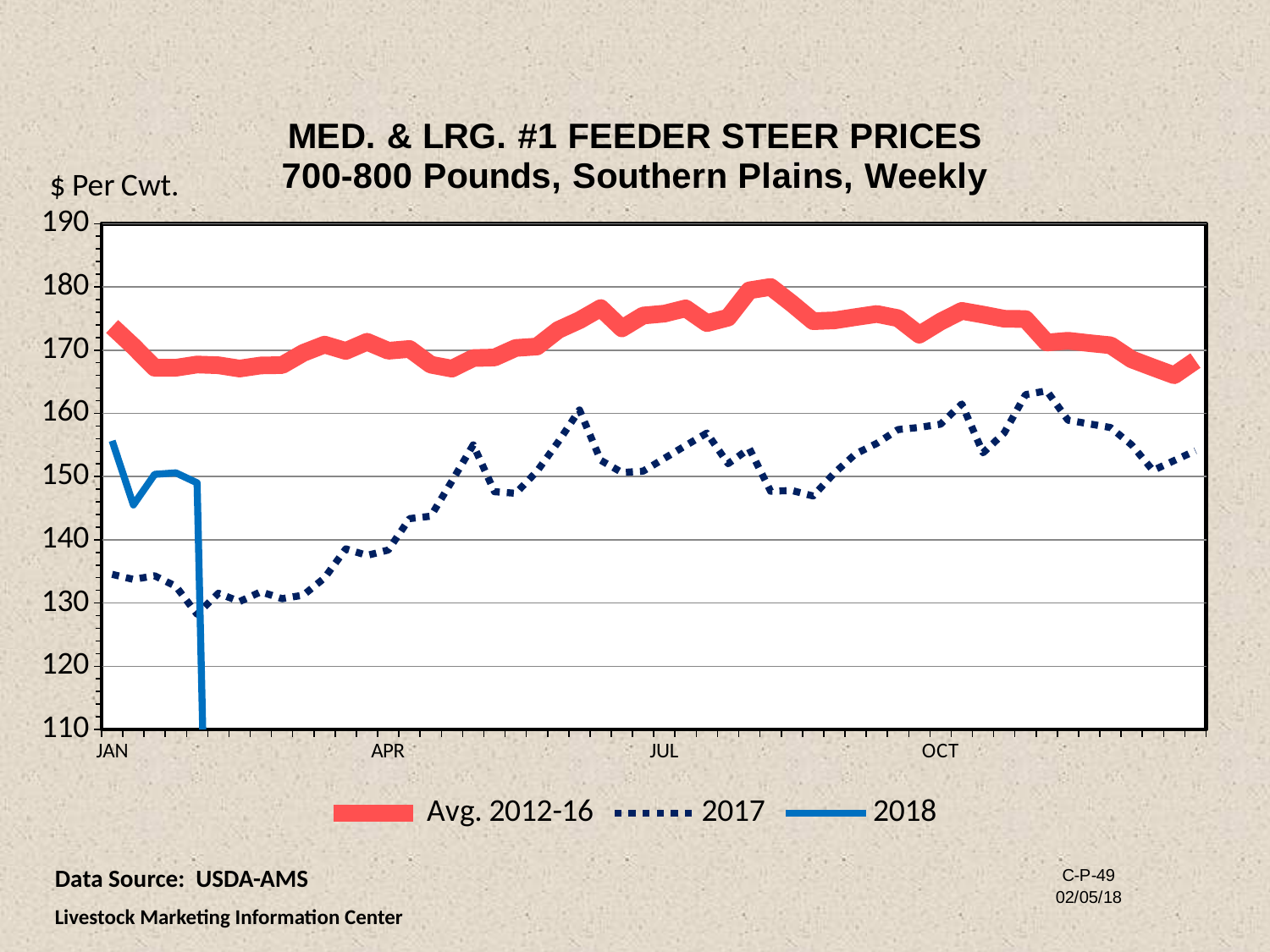
What kind of chart is shown on the slide? line chart Which series has the highest values across the whole year? Avg. 2012-16 Is the value for 2017 at JAN greater or less than 140? less At JAN, which series has the higher value, 2018 or 2017? 2018 Which series is plotted as a dotted line? 2017 Is the value for 2017 at OCT greater or less than 150? greater Is the value for Avg. 2012-16 at JAN greater or less than 170? greater At JAN, which series has the higher value, Avg. 2012-16 or 2017? Avg. 2012-16 What is the unit label shown on the y axis? $ Per Cwt. How many series does the legend list? 3 Does the 2017 series rise or fall from JAN to JUL? rise